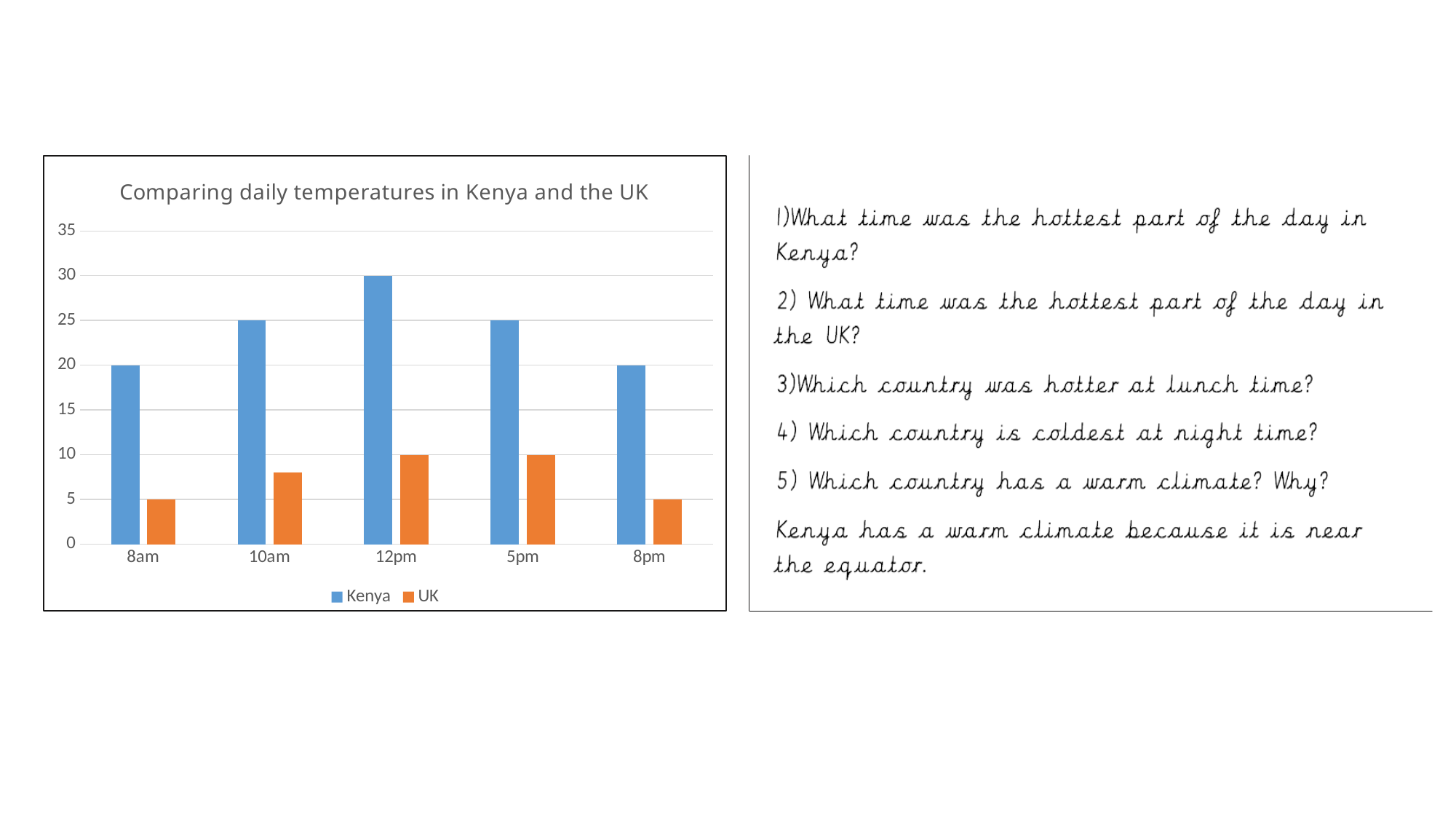
What is the value for Kenya at 12pm? 30 Do the Kenya values rise or fall from 8am to 12pm? rise What is the title of the chart? Comparing daily temperatures in Kenya and the UK What is the difference between the Kenya value and the UK value at 12pm? 20 What is the value for the UK at 8am? 5 Which is larger at 5pm, the value for Kenya or the value for the UK? Kenya What is the value for Kenya at 8pm? 20 Is the value for the UK at 10am greater or less than 5? greater At which time is the Kenya value highest? 12pm How many time categories are shown on the x axis? 5 How many series does the legend list? 2 What type of chart is shown on the slide? bar chart